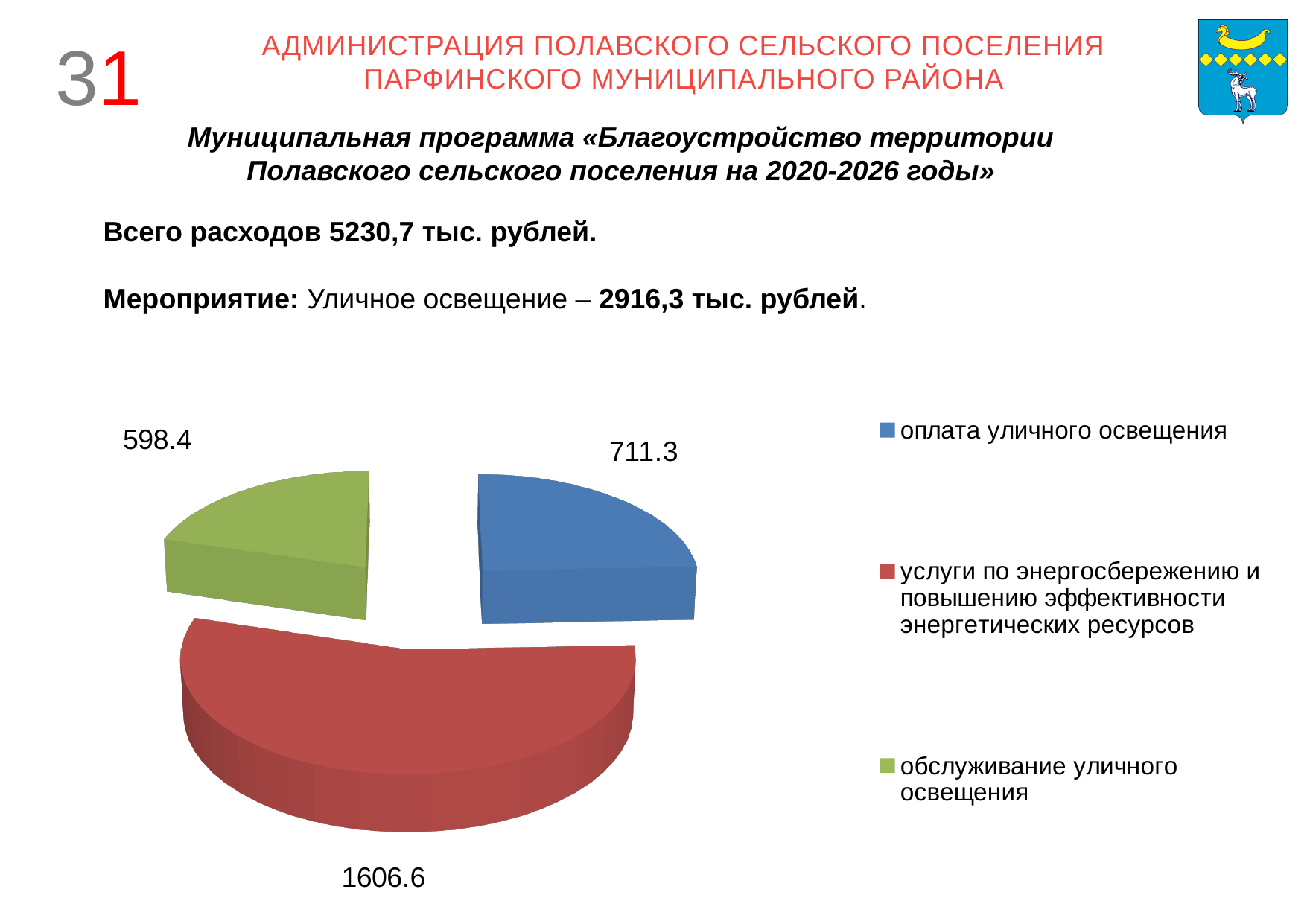
Which is larger: «оплата уличного освещения» or «обслуживание уличного освещения»? оплата уличного освещения What is the value for «оплата уличного освещения»? 711.3 What type of chart is shown on the slide? Pie chart What is the difference between the values for «оплата уличного освещения» and «обслуживание уличного освещения»? 112.9 Which category has the smallest slice of the pie? обслуживание уличного освещения What is the difference between the values for «услуги по энергосбережению и повышению эффективности энергетических ресурсов» and «оплата уличного освещения»? 895.3 Which category has the largest slice of the pie? услуги по энергосбережению и повышению эффективности энергетических ресурсов Which colour represents «обслуживание уличного освещения» in the pie chart? Green What is the total of all three slices in the pie chart? 2916.3 What is the value for «обслуживание уличного освещения»? 598.4 What is the value for «услуги по энергосбережению и повышению эффективности энергетических ресурсов»? 1606.6 How many slices does the pie chart have? 3